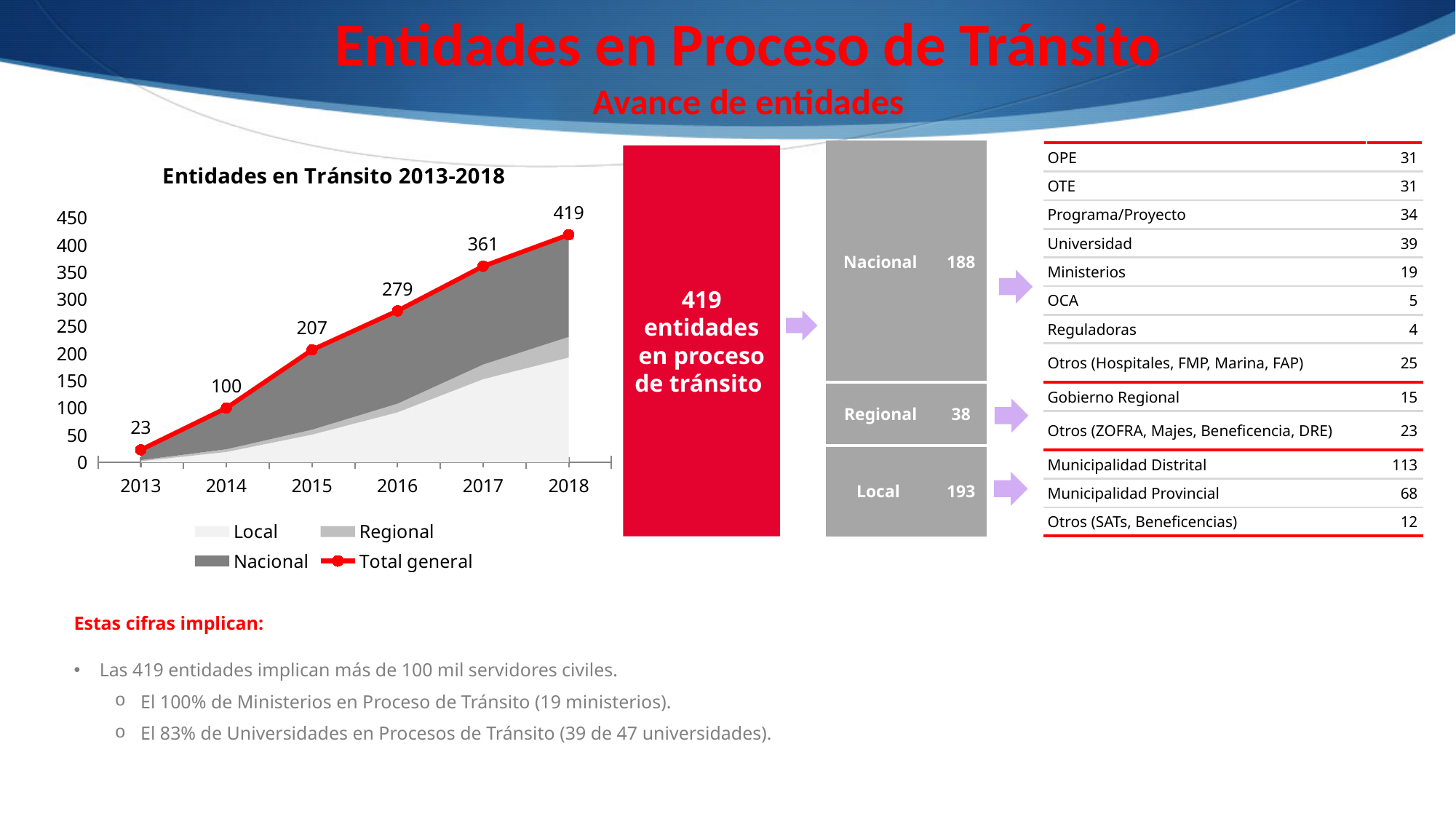
Does Total general rise or fall from 2013 to 2018? rise Which is larger, Total general in 2015 or in 2016? 2016 What is the value of Total general in 2013? 23 In which year is Total general highest? 2018 In which year is Total general lowest? 2013 What is the value of Total general in 2018? 419 What is the difference between Total general in 2016 and in 2014? 179 What is the value of Total general in 2015? 207 How many years are shown on the x axis of the chart? 6 What is the value of Total general in 2017? 361 How many series does the chart legend list? 4 What is the difference between Total general in 2018 and in 2017? 58